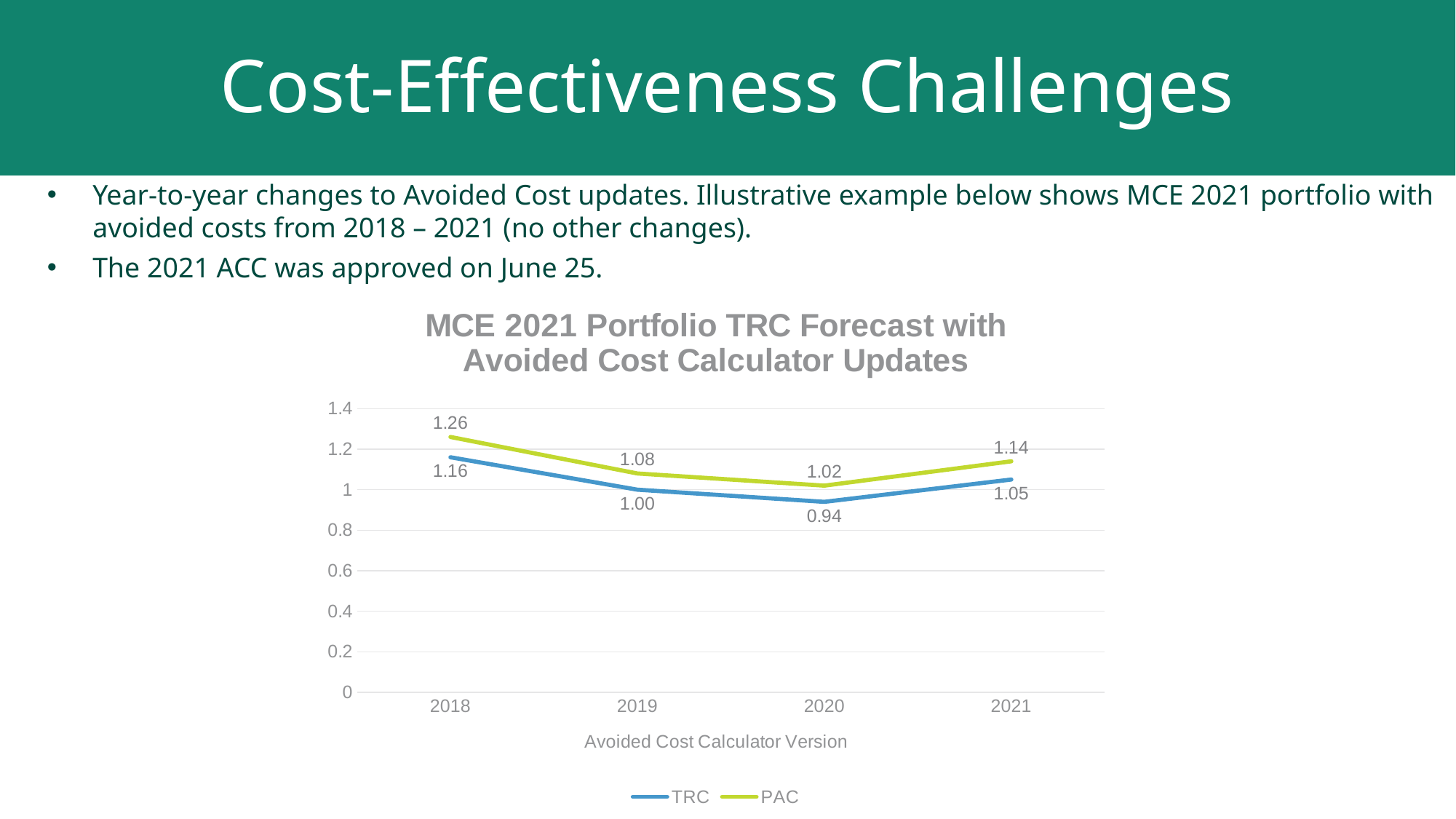
What is the TRC value for 2018? 1.16 Which Avoided Cost Calculator version has the lowest TRC value? 2020 How many series does the legend list? 2 What kind of chart is shown on the slide? Line chart How many Avoided Cost Calculator versions are shown on the x axis? 4 What is the PAC value for 2020? 1.02 What is the difference between the PAC and TRC values for 2018? 0.10 What is the TRC value for 2021? 1.05 What is the label of the x axis? Avoided Cost Calculator Version Which is larger, the TRC value for 2019 or the TRC value for 2021? 2021 What is the PAC value for 2019? 1.08 Which Avoided Cost Calculator version has the highest PAC value? 2018